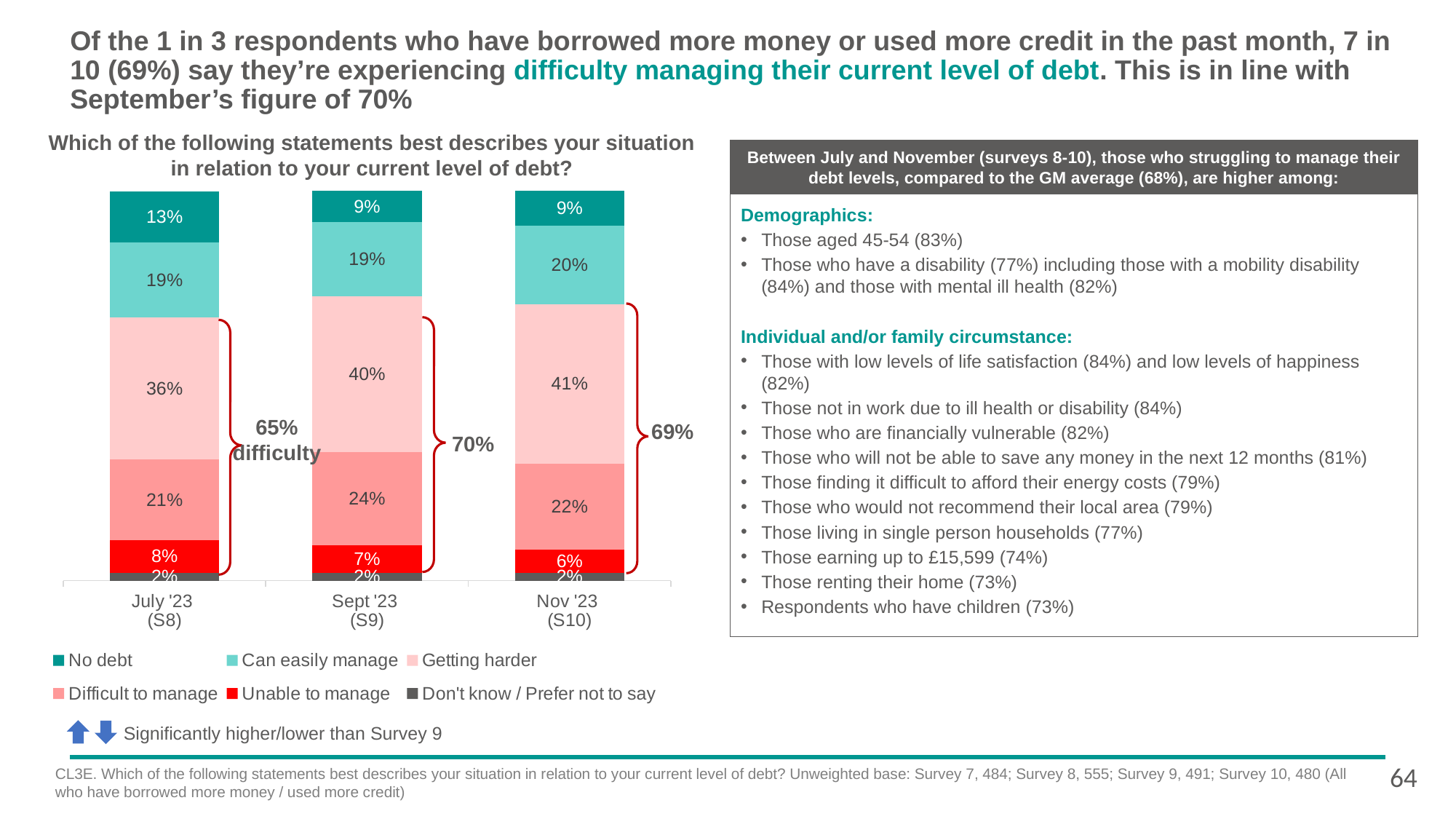
What kind of chart is used to show the debt situation responses? Stacked bar chart In which survey wave was the 'Getting harder' share the highest? Nov '23 (S10) What is the combined 'difficulty' share (Getting harder, Difficult to manage and Unable to manage) for Sept '23 (S9)? 71% What percentage of respondents in Sept '23 (S9) said their debt is 'Difficult to manage'? 24% How many series does the chart legend list? 6 In which survey wave was the 'No debt' share the highest? July '23 (S8) Which is larger: the 'Can easily manage' share in Nov '23 (S10) or in July '23 (S8)? Nov '23 (S10) How many survey waves are shown on the x axis of the chart? 3 What percentage of respondents in Nov '23 (S10) said they are 'Unable to manage' their debt? 6% What is the difference between the 'Difficult to manage' share in Sept '23 (S9) and in Nov '23 (S10)? 2 percentage points What percentage of respondents in July '23 (S8) said they have 'No debt'? 13% What percentage of respondents in Nov '23 (S10) said their debt is 'Getting harder'? 41%